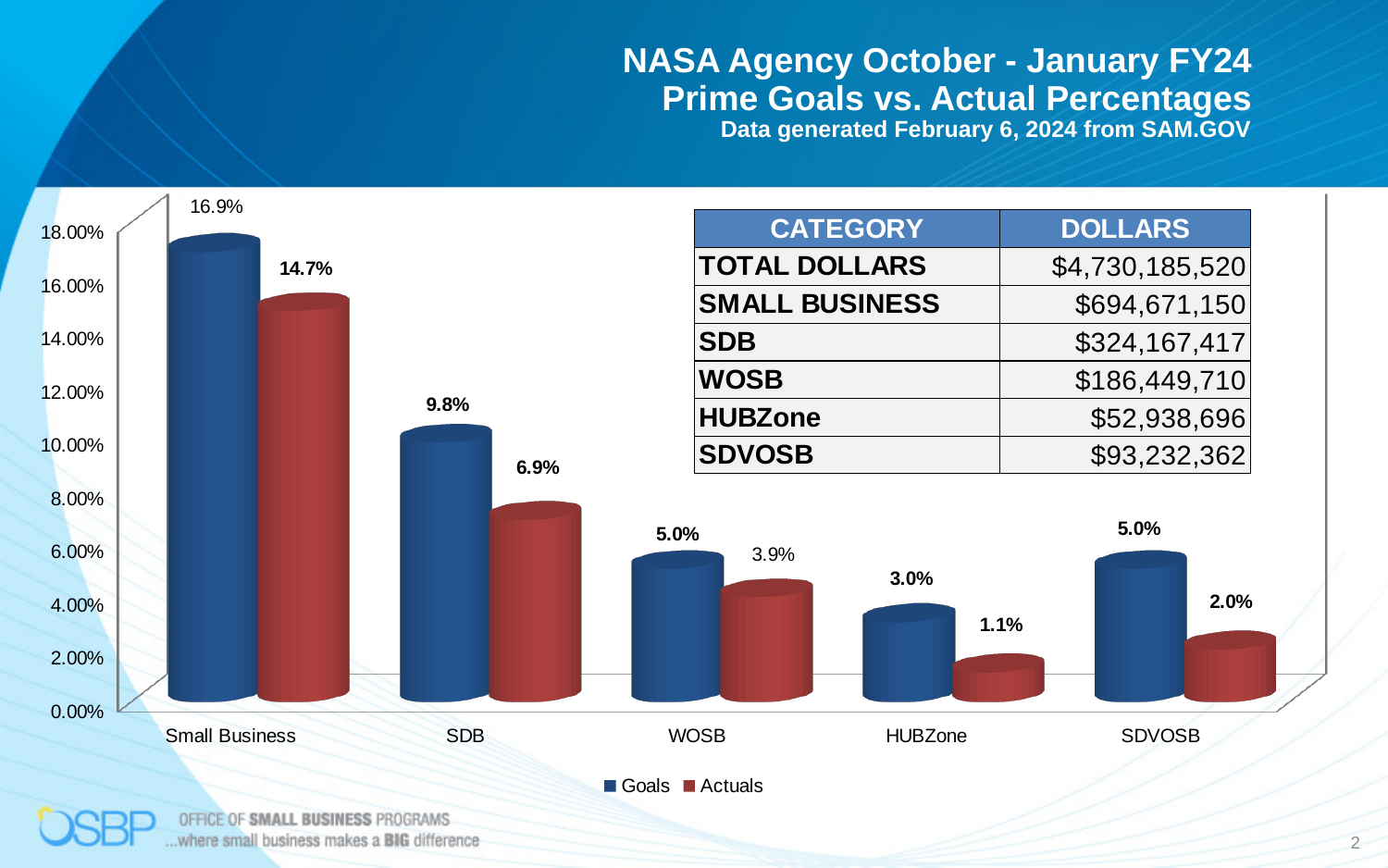
What is the Actuals value for SDB? 6.9% How many series does the legend list? 2 Which colour represents the Actuals series in the chart? Red What kind of chart is shown on the slide? Bar chart What is the Goals value for Small Business? 16.9% Which category has the highest Actuals value? Small Business How many categories are shown on the x axis? 5 What is the difference between the Goals and Actuals values for SDVOSB? 3.0% Which is larger, the Goals value for WOSB or the Actuals value for SDB? Actuals value for SDB What is the Actuals value for HUBZone? 1.1% Is the Actuals value for Small Business greater or less than 14.00%? greater Which category has the lowest Goals value? HUBZone